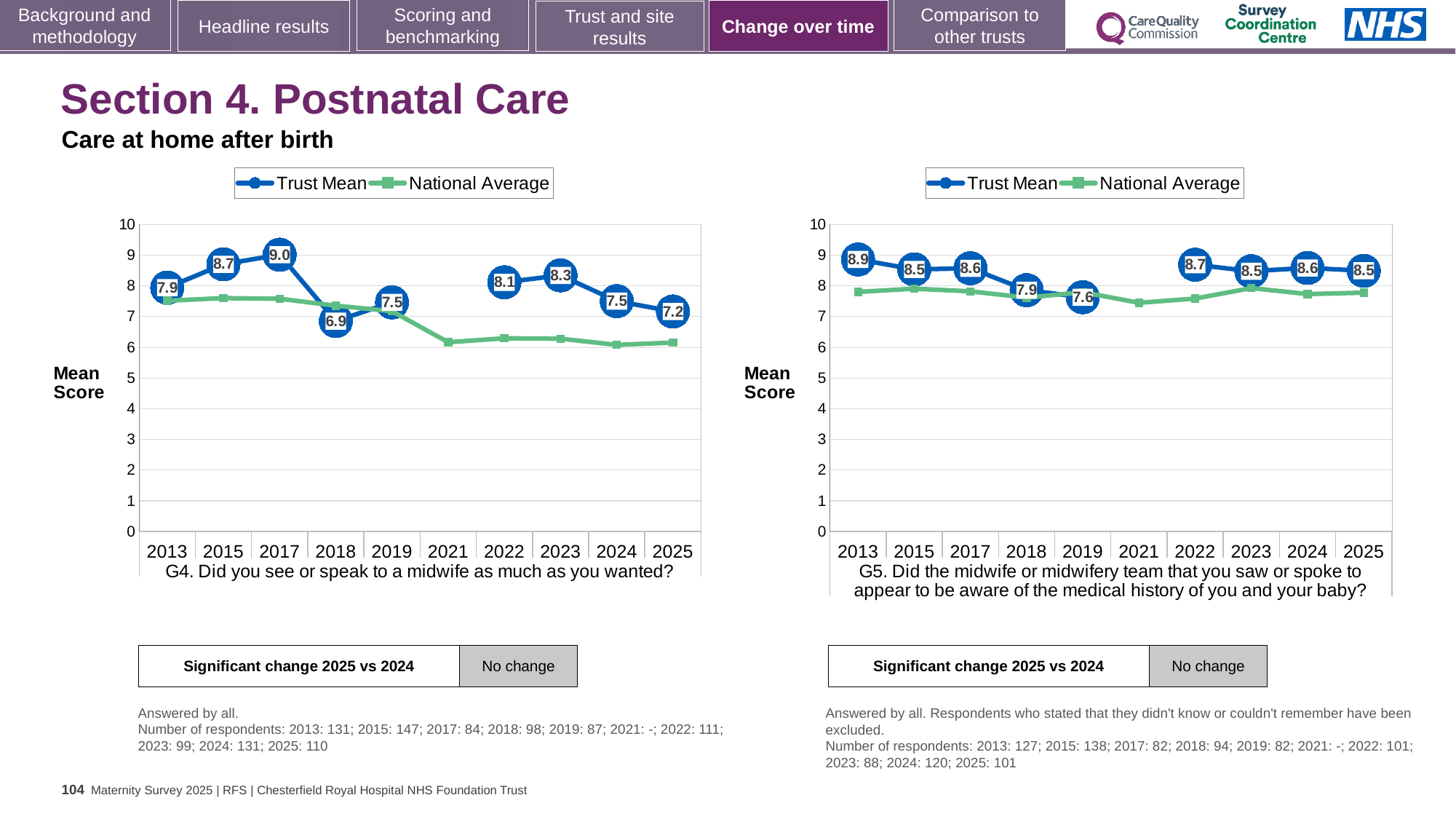
In the G4 chart, which year has the lowest Trust Mean score? 2018 What kind of chart is the G4 chart? Line chart In the G4 chart, what is the difference between the Trust Mean scores for 2017 and 2018? 2.1 In the G4 chart, is the National Average for 2025 greater or less than 7? less How many years are shown on the x axis of the G4 chart? 10 In the G4 chart, what is the Trust Mean score for 2017? 9.0 How many series does the legend of the G5 chart list? 2 In the G4 chart, what is the Trust Mean score for 2025? 7.2 In the G5 chart, what is the difference between the Trust Mean scores for 2024 and 2025? 0.1 In the G5 chart, which year has the lowest Trust Mean score? 2019 In the G5 chart, which is higher, the Trust Mean for 2022 or for 2019? 2022 In the G5 chart, what is the Trust Mean score for 2013? 8.9